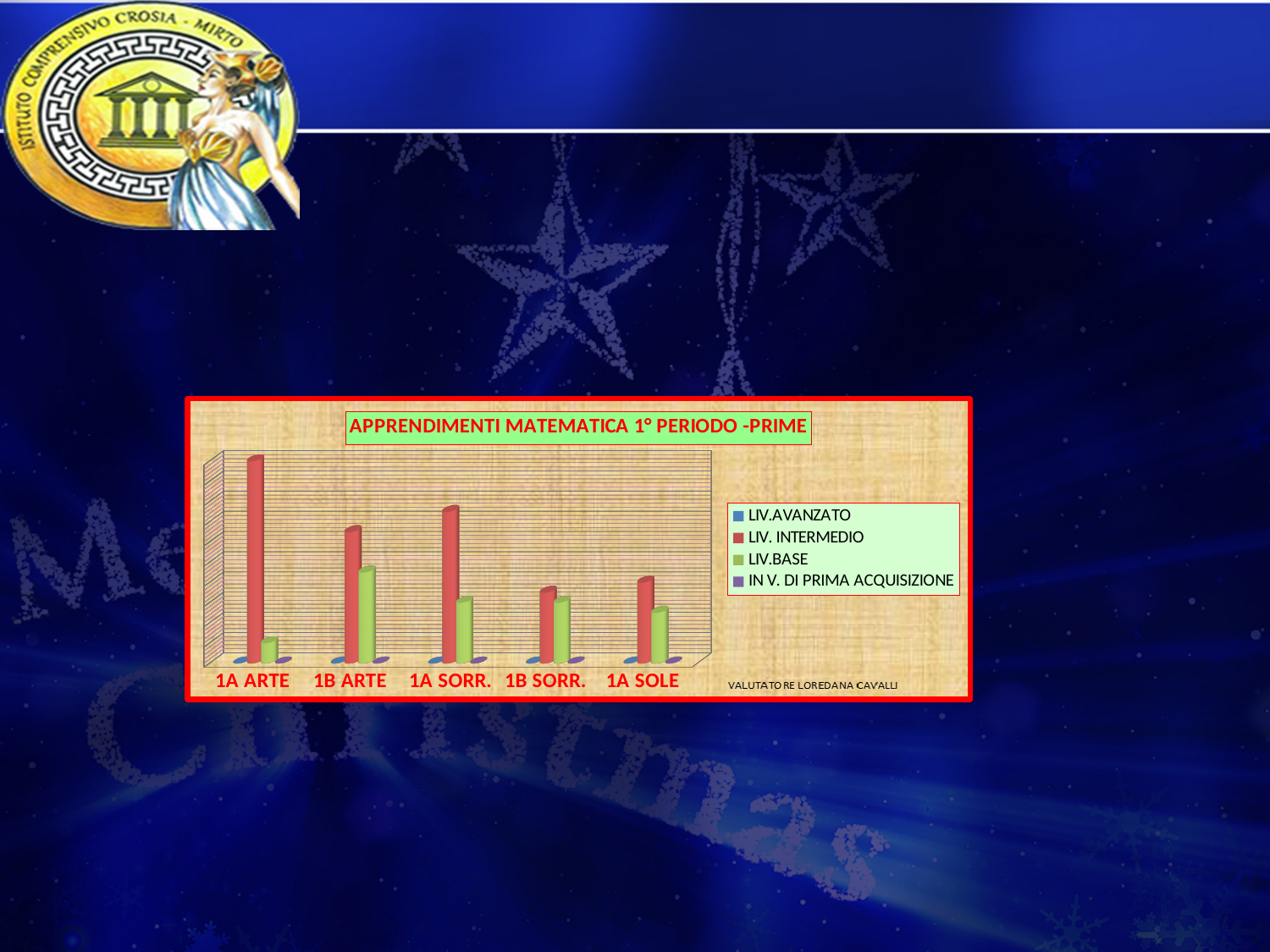
For 1A ARTE, which is larger: the LIV. INTERMEDIO bar or the LIV.BASE bar? LIV. INTERMEDIO How many classes (categories) are shown on the x axis? 5 Which class has the lowest LIV.BASE bar? 1A ARTE Which class has the highest LIV. INTERMEDIO bar? 1A ARTE How many series does the legend list? 4 What is the title of the chart? APPRENDIMENTI MATEMATICA 1° PERIODO -PRIME Which series is shown in green in the legend? LIV.BASE Which class has the highest LIV.BASE bar? 1B ARTE What kind of chart is shown on the slide? bar chart Which class has the larger LIV. INTERMEDIO bar, 1A ARTE or 1B SORR.? 1A ARTE Which class has the larger LIV. INTERMEDIO bar, 1B ARTE or 1A SORR.? 1A SORR.